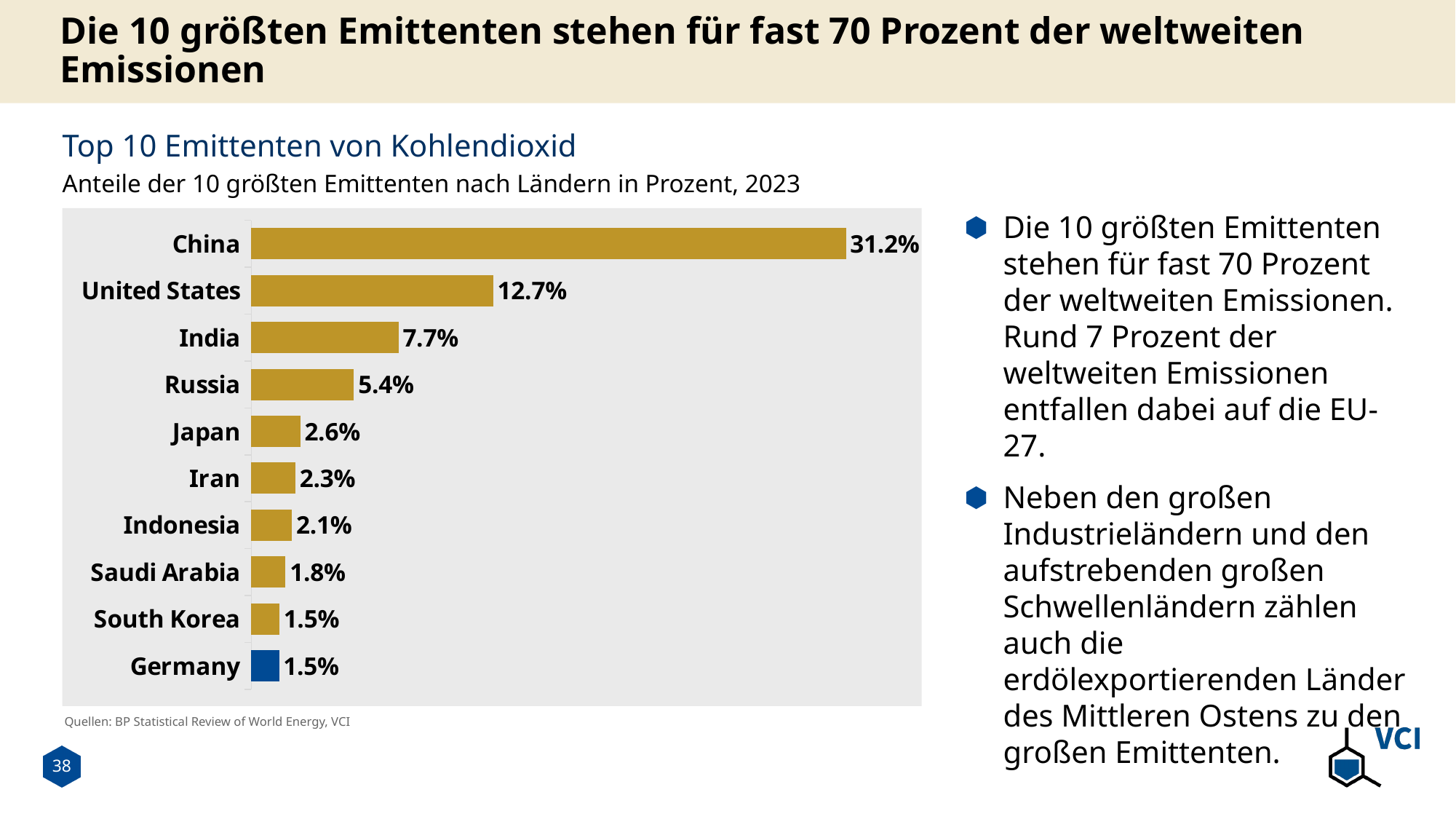
What is the difference between the values for China and the United States? 18.5% What is the value for India? 7.7% Which is larger, the value for Iran or the value for Indonesia? Iran Which country's bar is coloured blue instead of gold? Germany Do the values rise or fall from the top bar to the bottom bar? fall What kind of chart is this? bar chart What is the value for Saudi Arabia? 1.8% How many countries are shown in the chart? 10 What is the difference between the values for Russia and Japan? 2.8% What is the value for China? 31.2% What is the title of the chart? Top 10 Emittenten von Kohlendioxid Which country has the highest share? China